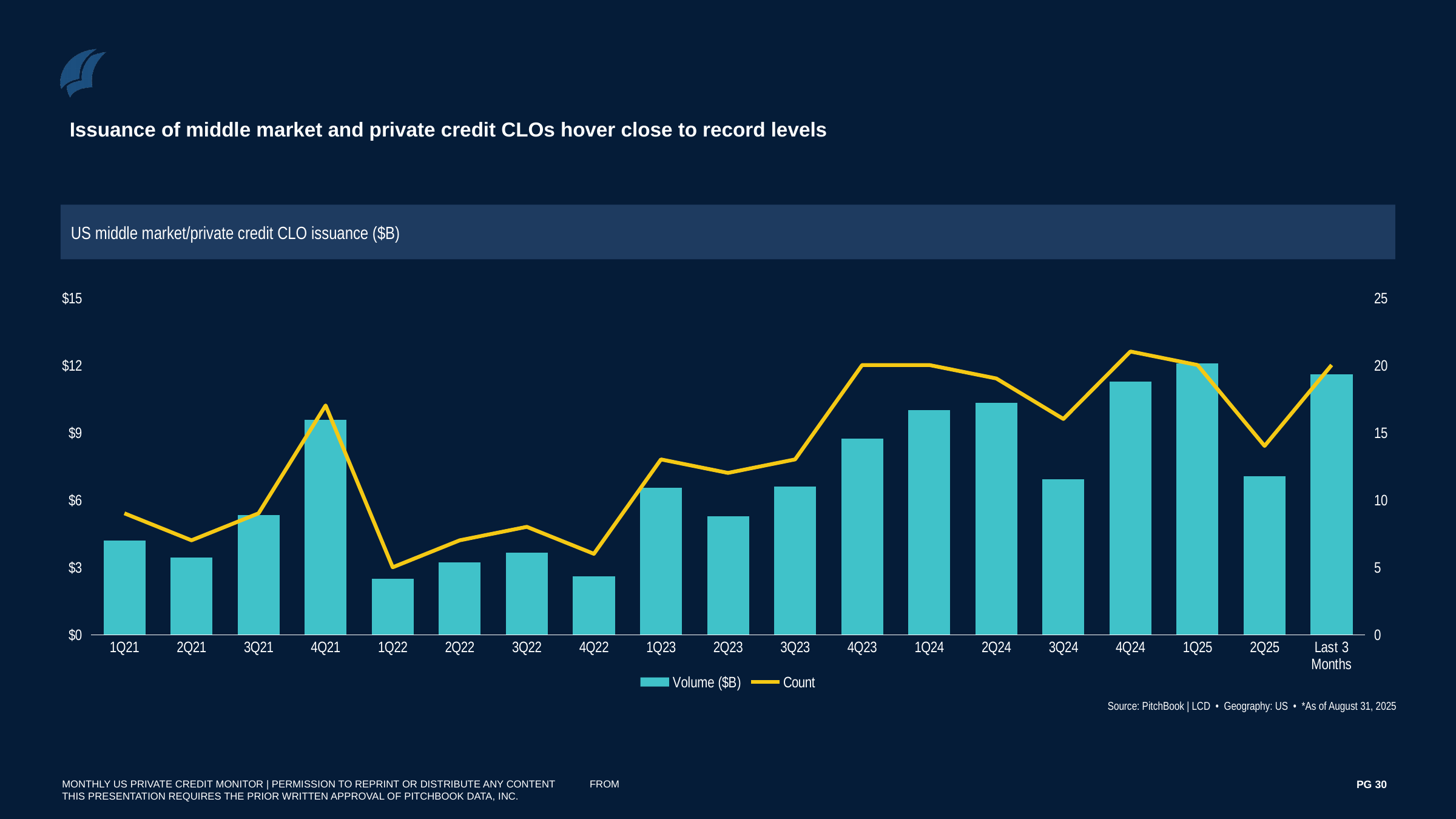
How many categories are shown along the x axis? 19 Is the Count value for 4Q24 greater or less than 20? greater What is the title shown in the banner above the chart? US middle market/private credit CLO issuance ($B) Which has the larger Volume ($B), 4Q21 or 1Q22? 4Q21 Is the Volume ($B) value for 4Q21 greater or less than $9? greater Do the Volume ($B) bars rise or fall from 2Q23 to 2Q24? rise Is the Volume ($B) value for 3Q24 greater or less than $6? greater What type of chart is shown on the slide? Bar chart with a line overlay Which has the larger Volume ($B), 1Q24 or 3Q24? 1Q24 How many series does the legend list? 2